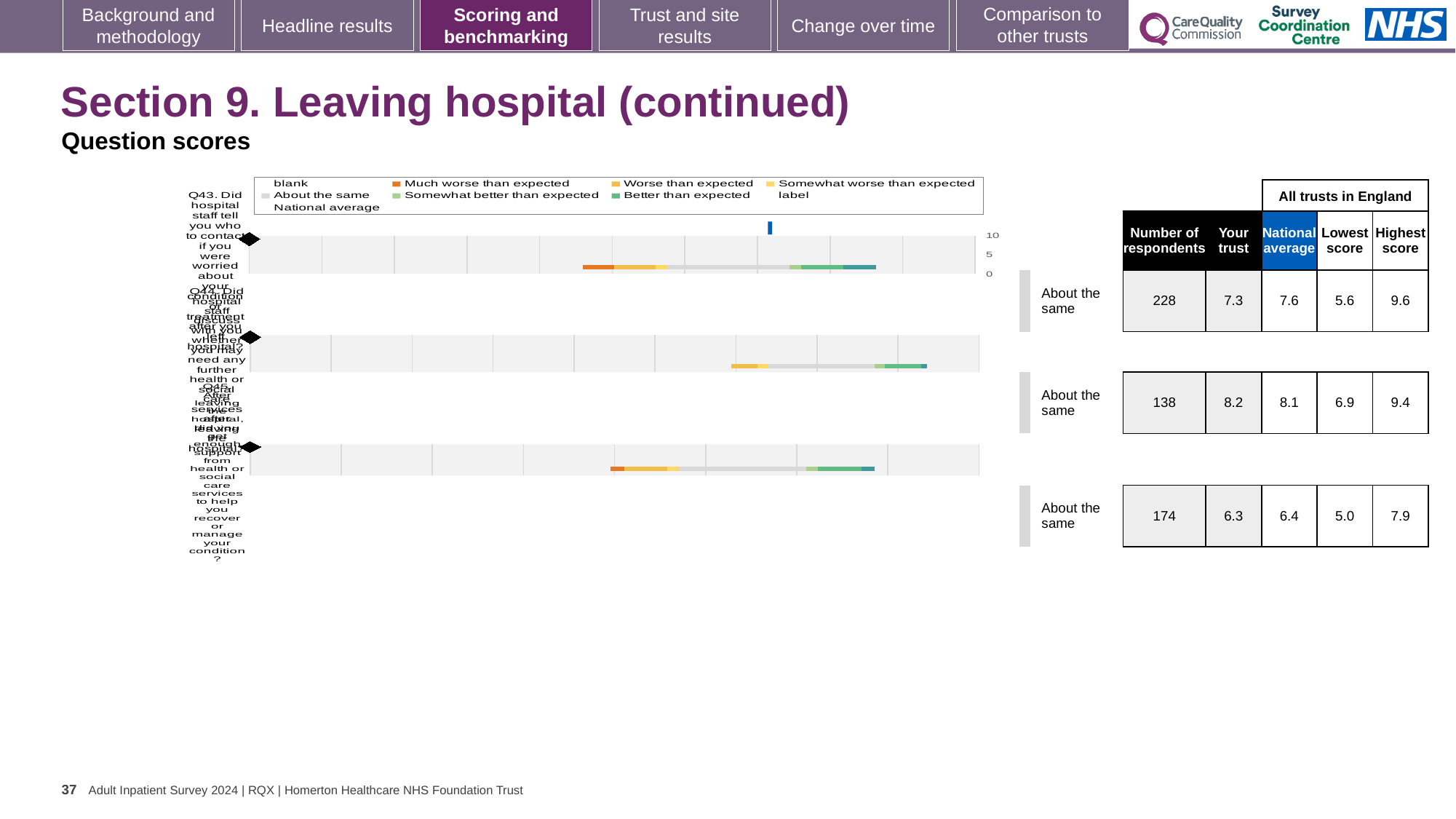
Which question row has the highest 'Your trust' score? the second row (8.2) Which question row has the lowest number of respondents? the second row (138) What colour does the legend use for 'Much worse than expected'? orange How many question rows are plotted on the slide? 3 What kind of chart is used to show the question scores on this slide? bar chart What is the highest value shown on the chart's score axis? 10 For the first question row (Q43), what is the difference between the highest score (9.6) and the lowest score (5.6)? 4.0 For the first question row (Q43), what is the 'Your trust' score shown in the table beside the chart? 7.3 For the first question row (Q43), what is the national average score shown beside the chart? 7.6 What benchmark category is shown for all three question rows? About the same For the first question row (Q43), which is larger: the 'Your trust' score or the national average? National average How many respondents are listed for the second question row? 138